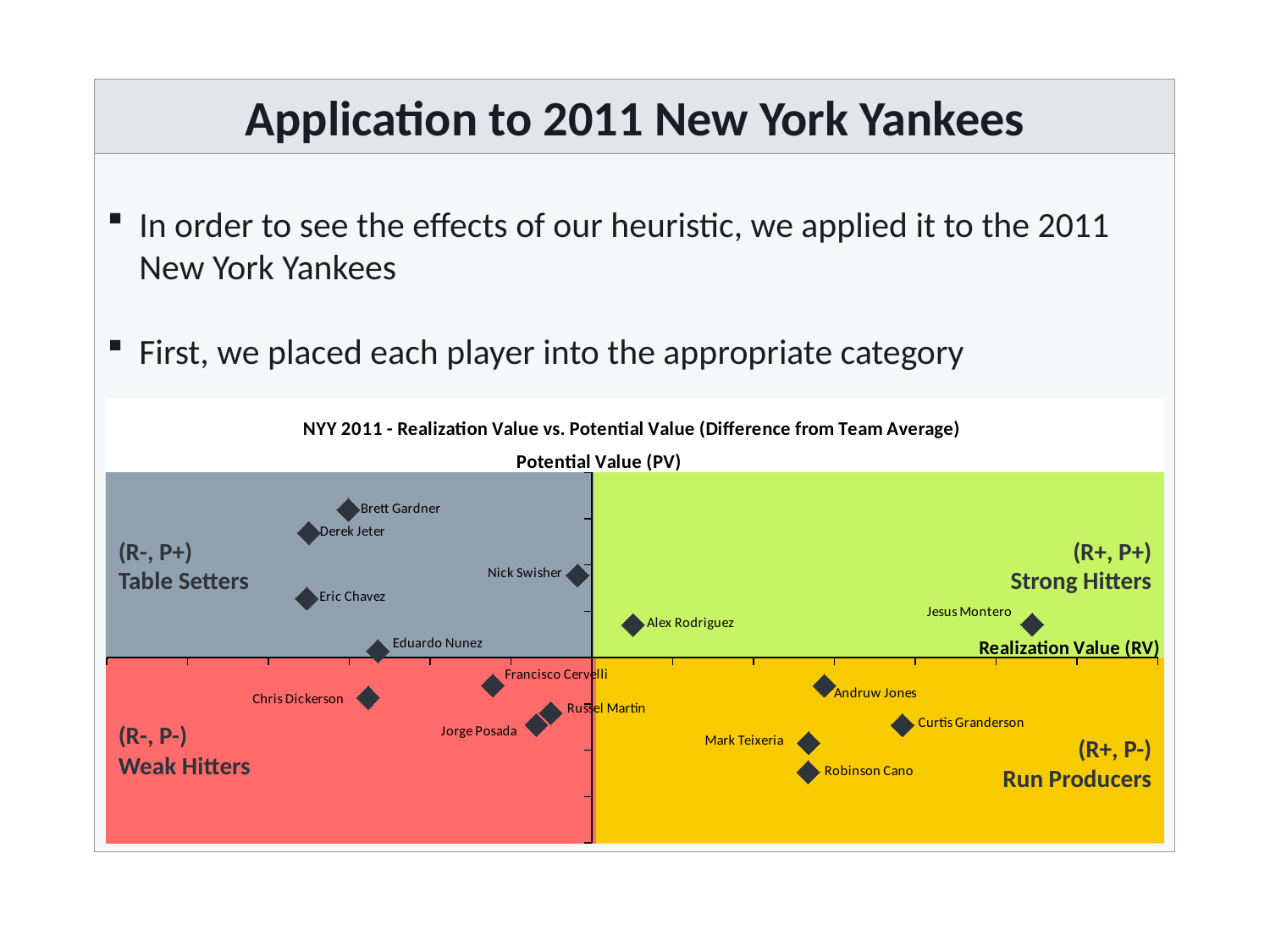
Who has the higher Realization Value, Alex Rodriguez or Jesus Montero? Jesus Montero Which player has the highest Potential Value on the chart? Brett Gardner Who has the higher Potential Value, Brett Gardner or Derek Jeter? Brett Gardner Which player has the highest Realization Value on the chart? Jesus Montero What is the title of the chart? NYY 2011 - Realization Value vs. Potential Value (Difference from Team Average) Which quadrant category does Curtis Granderson fall into on the chart? (R+, P-) Run Producers What label is given to the vertical axis of the chart? Potential Value (PV) Which player has the lowest Potential Value on the chart? Robinson Cano What kind of chart is shown on the slide? scatter chart How many players are plotted on the chart? 15 Which quadrant category does Alex Rodriguez fall into on the chart? (R+, P+) Strong Hitters Which quadrant category does Chris Dickerson fall into on the chart? (R-, P-) Weak Hitters